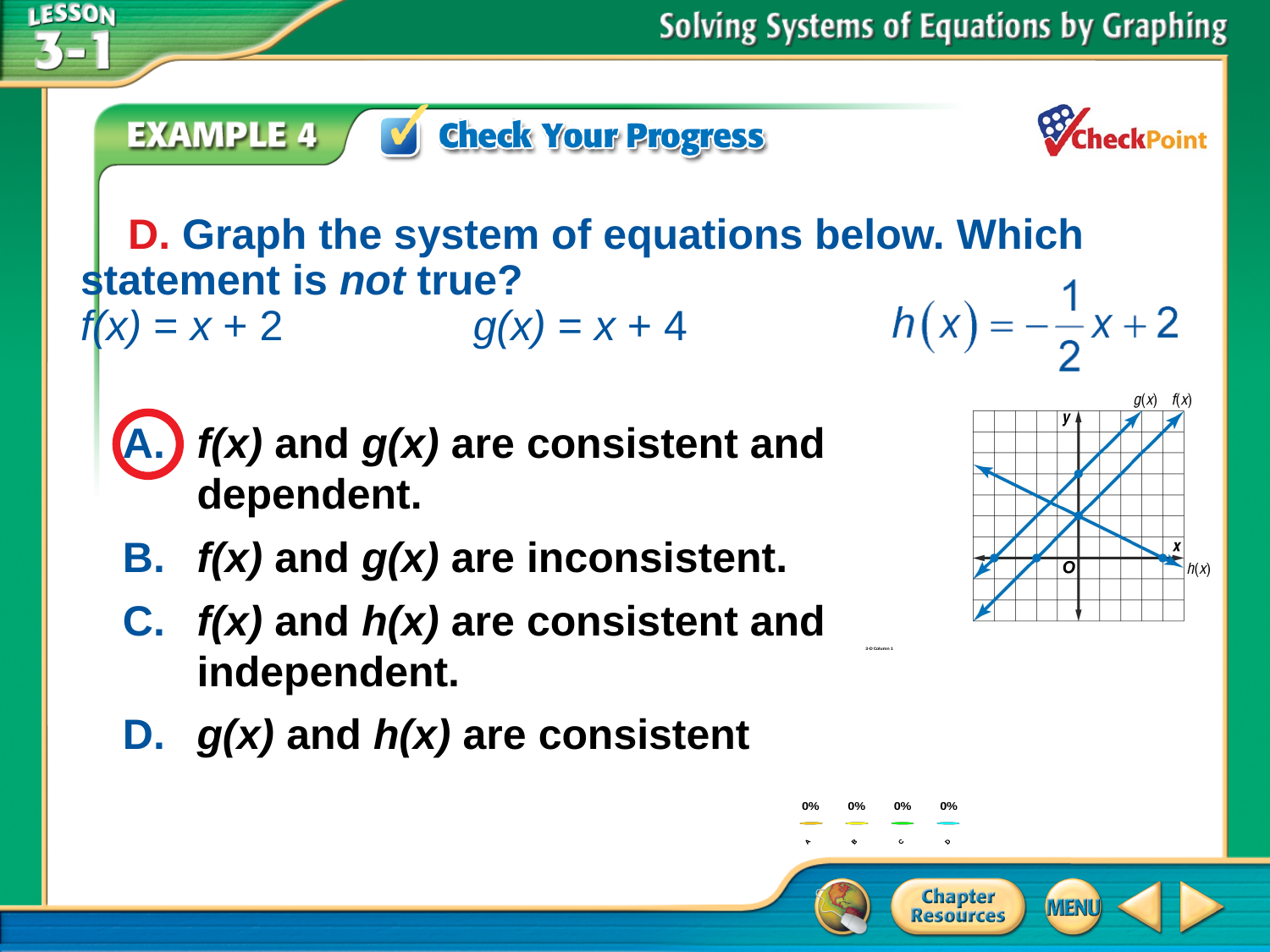
In the small bar chart at the bottom of the slide, what is the difference between the values for A and B? 0% In the coordinate graph on the right of the slide, how many lines are plotted? 3 What kind of chart is the graph on the right of the slide? line graph How many categories does the small bar chart at the bottom of the slide have? 4 In the small bar chart at the bottom of the slide, what is the value shown for D? 0% In the small bar chart at the bottom of the slide, what is the value shown for C? 0% In the coordinate graph on the right of the slide, which line falls as x increases? h(x) In the coordinate graph on the right of the slide, does the line f(x) rise or fall as x increases? rise In the coordinate graph on the right of the slide, what are the labels of the three plotted lines? g(x), f(x), h(x) What kind of chart is the small chart at the bottom of the slide with the 0% labels? bar chart In the small bar chart at the bottom of the slide, what is the value shown for A? 0% In the coordinate graph on the right of the slide, which two lines are parallel? f(x) and g(x)